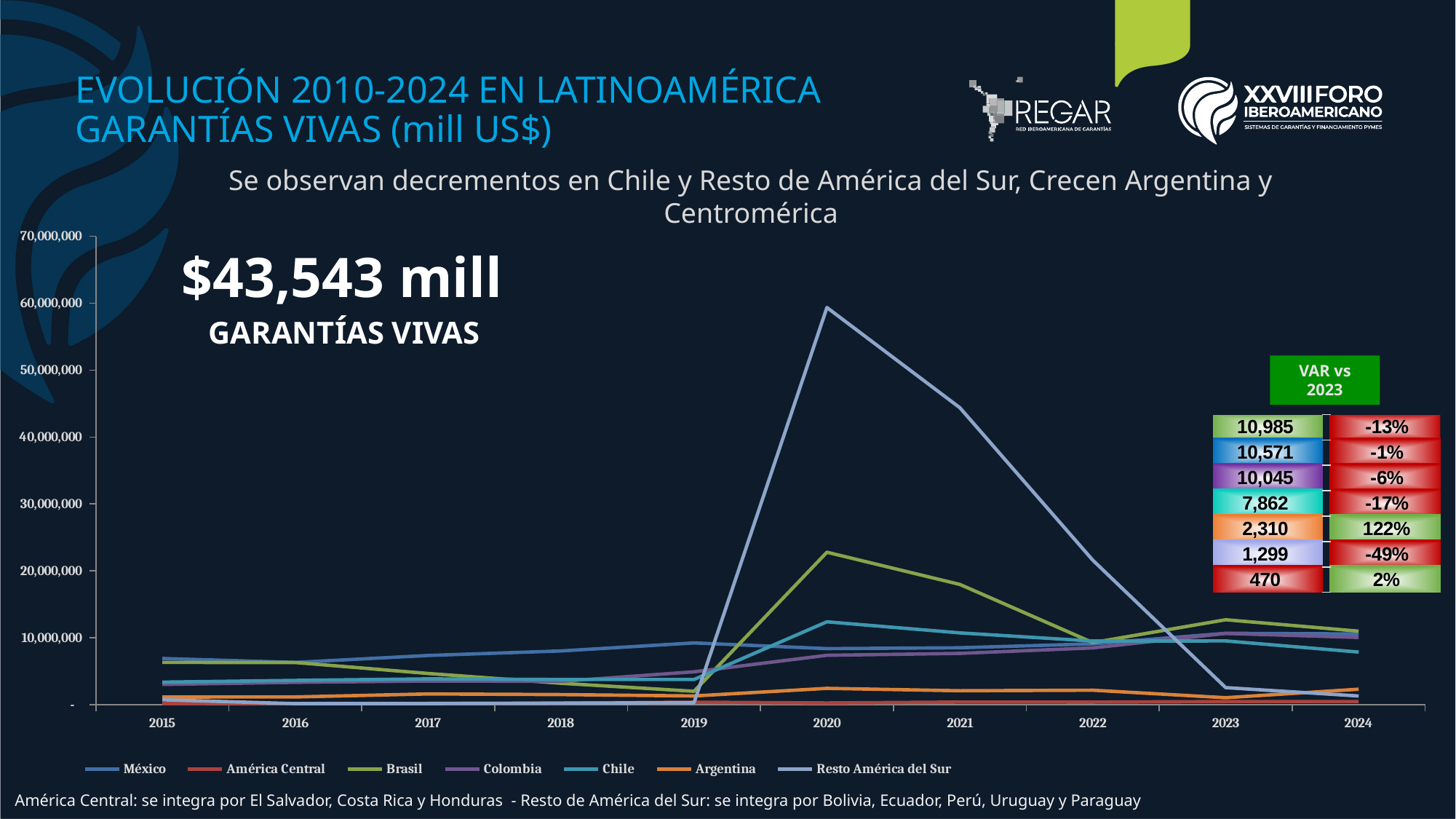
How many series does the chart legend list? 7 What is the lowest percentage shown in the VAR vs 2023 table? -49% Does the Resto América del Sur line rise or fall from 2020 to 2024? fall Is the value for Resto América del Sur in 2023 greater or less than 10,000,000? less Is the value for Resto América del Sur in 2020 greater or less than 50,000,000? greater What is the largest percentage shown in the VAR vs 2023 table? 122% What type of chart is shown on the slide? line chart How many years are plotted along the x axis of the chart? 10 Is the value for Brasil in 2020 greater or less than 20,000,000? greater In 2020, which is larger: the value for Brasil or the value for Chile? Brasil What total figure for garantías vivas is printed in large text on the slide? $43,543 mill Which series reaches the highest value in 2020? Resto América del Sur